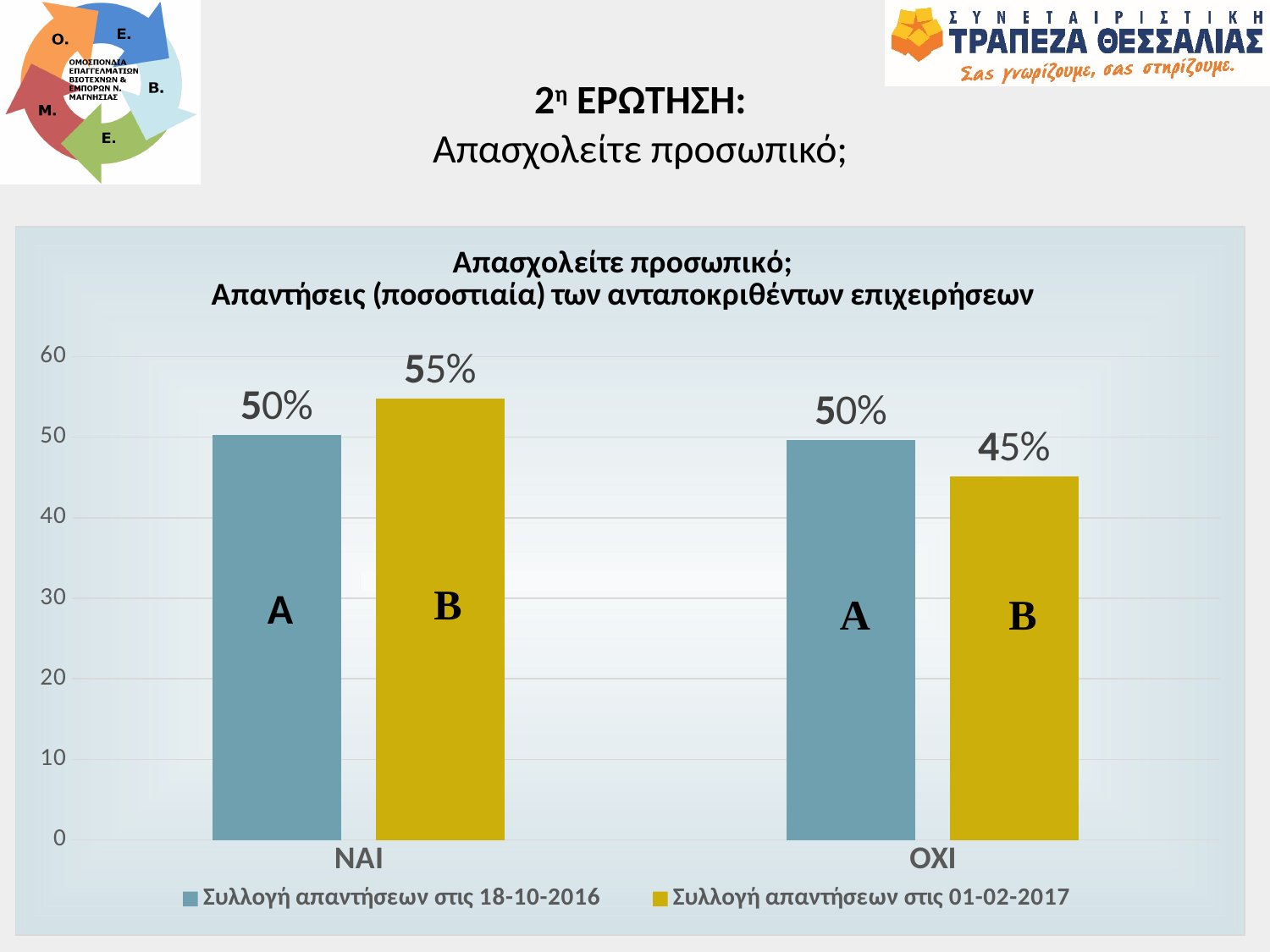
What is the value for ΟΧΙ in the series 'Συλλογή απαντήσεων στις 18-10-2016'? 50% What is the difference between the ΝΑΙ and ΟΧΙ values in the series 'Συλλογή απαντήσεων στις 01-02-2017'? 10% What kind of chart is shown on the slide? Bar chart Which category has the lowest value in the series 'Συλλογή απαντήσεων στις 01-02-2017'? ΟΧΙ How many categories are shown on the x axis? 2 What is the value for ΟΧΙ in the series 'Συλλογή απαντήσεων στις 01-02-2017'? 45% For ΟΧΙ, which series has the larger value: 'Συλλογή απαντήσεων στις 18-10-2016' or 'Συλλογή απαντήσεων στις 01-02-2017'? Συλλογή απαντήσεων στις 18-10-2016 What is the value for ΝΑΙ in the series 'Συλλογή απαντήσεων στις 01-02-2017'? 55% How many series does the legend list? 2 Which category has the highest value in the series 'Συλλογή απαντήσεων στις 01-02-2017'? ΝΑΙ What is the value for ΝΑΙ in the series 'Συλλογή απαντήσεων στις 18-10-2016'? 50% What is the title of the chart? Απασχολείτε προσωπικό; Απαντήσεις (ποσοστιαία) των ανταποκριθέντων επιχειρήσεων